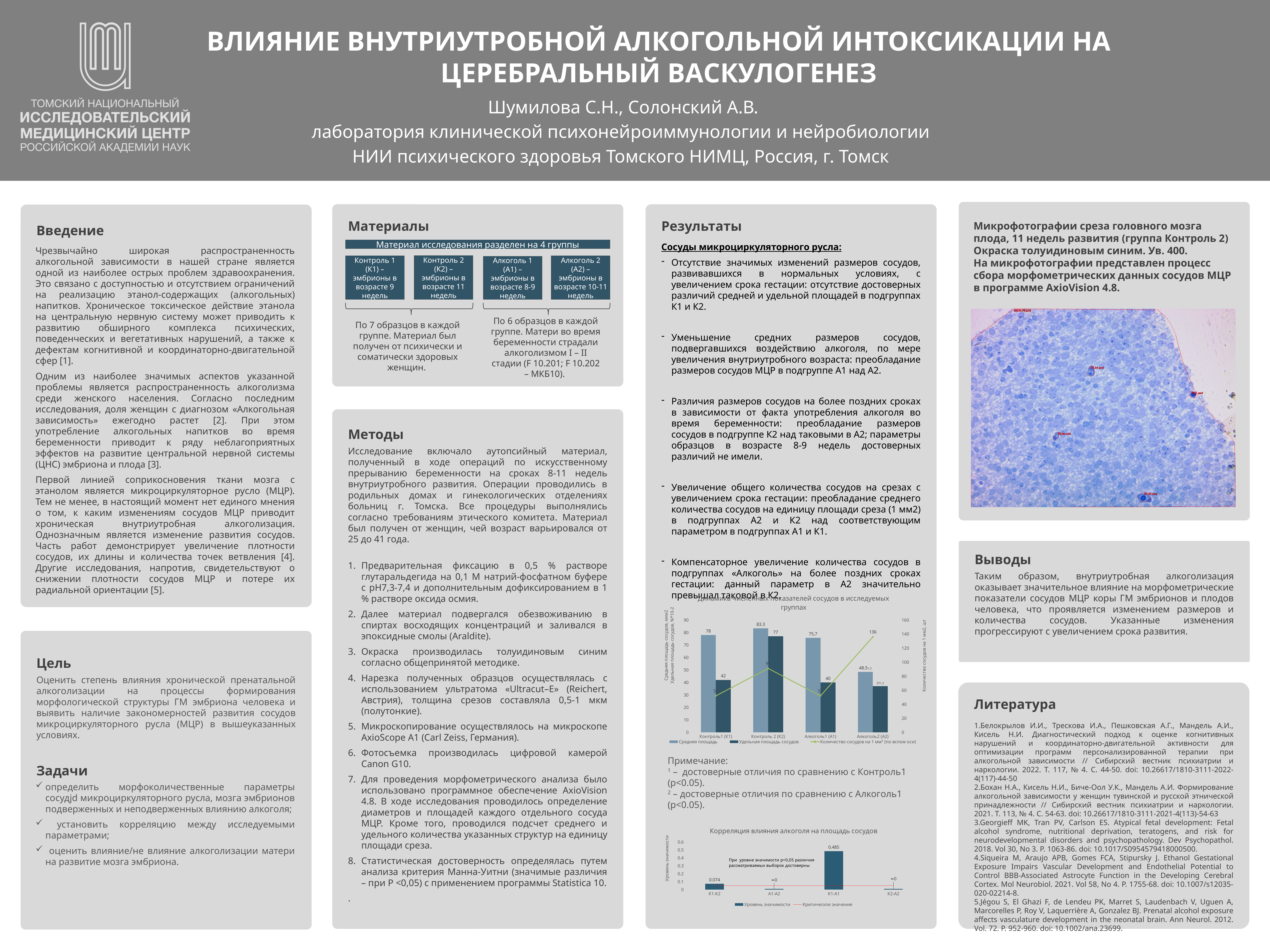
In the chart 'Динамика численных показателей сосудов в исследуемых группах', what is the value of 'Удельная площадь сосудов' for Контроль1 (К1)? 42 In the chart 'Динамика численных показателей сосудов в исследуемых группах', which group has the lowest 'Удельная площадь сосудов'? Алкоголь2 (А2) In the chart 'Динамика численных показателей сосудов в исследуемых группах', what is the value of 'Количество сосудов на 1 мм²' for Алкоголь2 (А2)? 136 In the chart 'Корреляция влияния алкоголя на площадь сосудов', what is the value of 'Уровень значимости' for К1-К2? 0.074 How many series does the legend of the chart 'Динамика численных показателей сосудов в исследуемых группах' list? 3 In the chart 'Динамика численных показателей сосудов в исследуемых группах', which group has the highest 'Средняя площадь'? Контроль 2 (К2) How many groups are shown on the x axis of the chart 'Динамика численных показателей сосудов в исследуемых группах'? 4 In the chart 'Динамика численных показателей сосудов в исследуемых группах', which is larger: 'Средняя площадь' for Контроль1 (К1) or for Алкоголь1 (А1)? Контроль1 (К1) In the chart 'Динамика численных показателей сосудов в исследуемых группах', what is the difference between 'Удельная площадь сосудов' for Контроль 2 (К2) and Алкоголь1 (А1)? 37 In the chart 'Корреляция влияния алкоголя на площадь сосудов', what is the value of 'Уровень значимости' for К1-А1? 0.485 In the chart 'Динамика численных показателей сосудов в исследуемых группах', what is the value of 'Средняя площадь' for Контроль 2 (К2)? 83.3 What kind of chart is 'Корреляция влияния алкоголя на площадь сосудов'? Combination bar and line chart